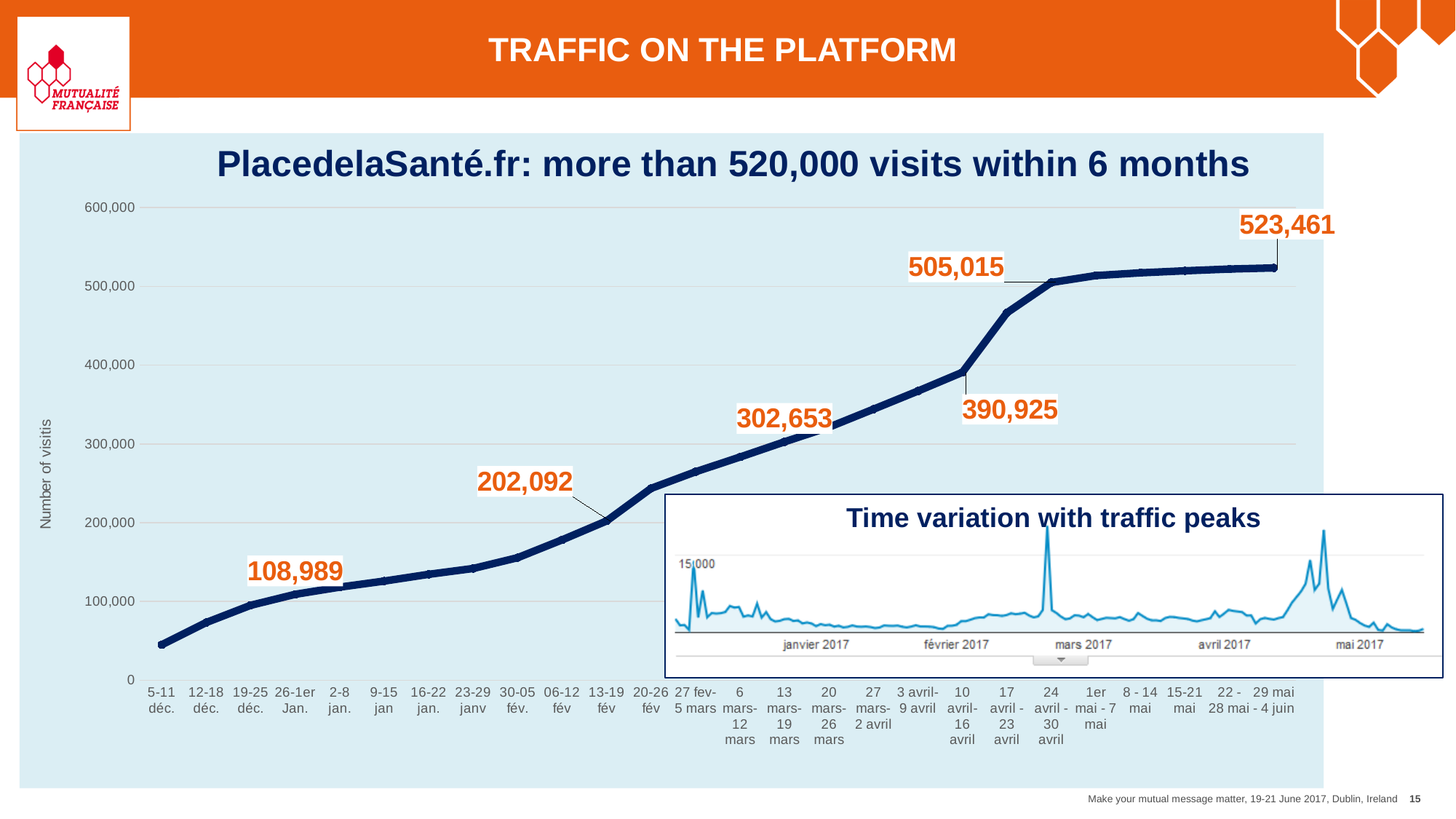
On the main chart, what value is labelled at the 13-19 fév point? 202,092 Do the values on the main chart rise or fall from left to right along the x axis? rise On the main chart, what value is labelled at the 24 avril - 30 avril point? 505,015 What is the title of the inset chart in the lower right of the slide? Time variation with traffic peaks What is the final cumulative value shown at the end of the main line chart (29 mai - 4 juin)? 523,461 On the main chart, is the value for 5-11 déc. greater or less than 100,000? less What kind of chart is the main chart on the slide? line chart On the main chart, what is the difference between the labelled values 523,461 and 505,015? 18,446 On the main chart, is the value for 2-8 jan. greater or less than 100,000? greater On the main chart, what is the difference between the labelled values 505,015 and 390,925? 114,090 On the main chart, what value is labelled at the 10 avril - 16 avril point? 390,925 On the main chart, what is the difference between the labelled values 202,092 and 108,989? 93,103